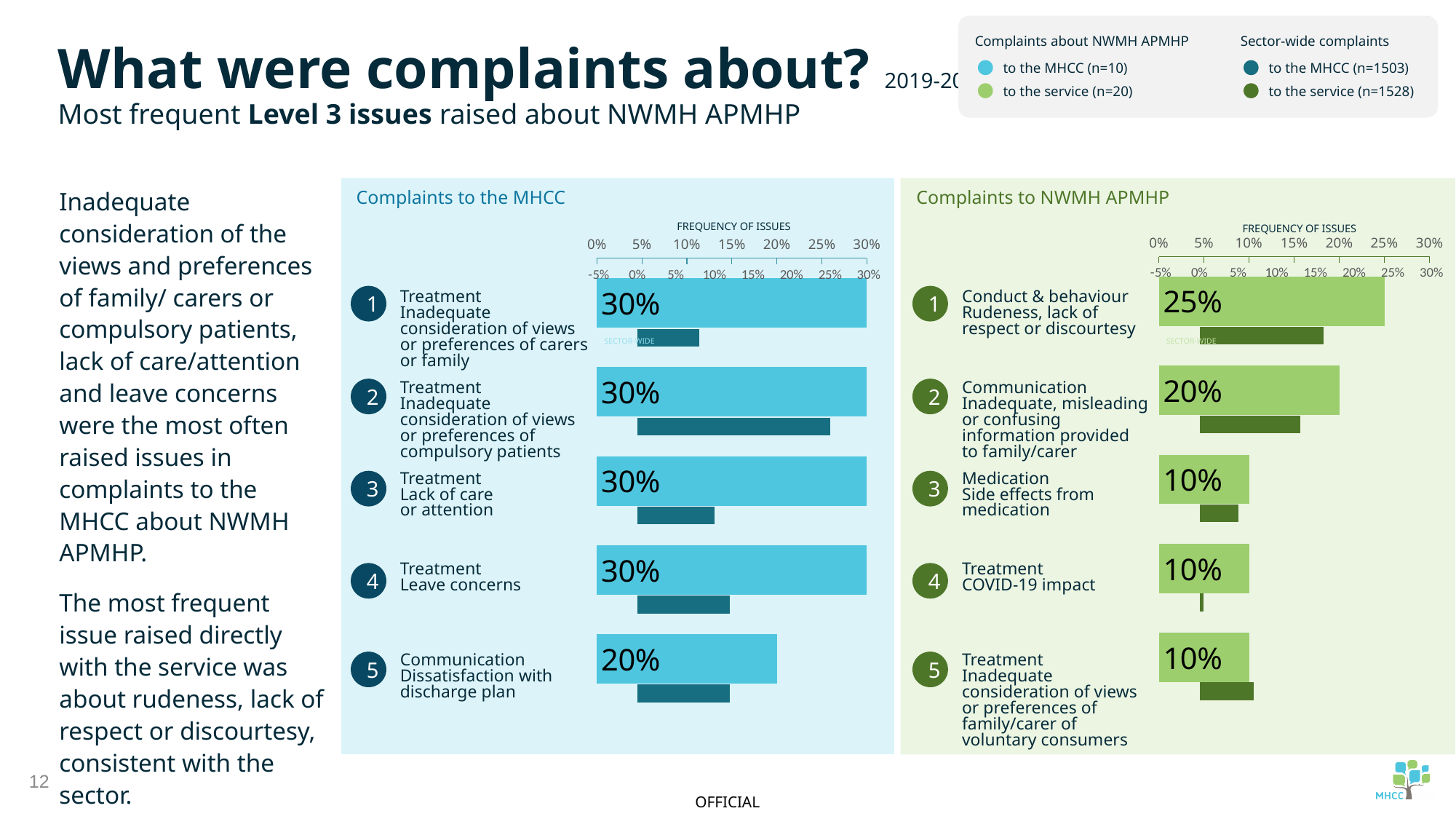
In the 'Complaints to the MHCC' chart, what is the value for 'Communication – Dissatisfaction with discharge plan'? 20% How many issues are listed in the 'Complaints to NWMH APMHP' chart? 5 In the 'Complaints to the MHCC' chart, is the sector-wide bar for 'Treatment – Inadequate consideration of views or preferences of compulsory patients' greater or less than 20%? greater In the 'Complaints to the MHCC' chart, what is the value for 'Treatment – Leave concerns'? 30% In the 'Complaints to NWMH APMHP' chart, what is the value for 'Communication – Inadequate, misleading or confusing information provided to family/carer'? 20% In the 'Complaints to the MHCC' chart, which issue has the lowest frequency? Communication – Dissatisfaction with discharge plan In the 'Complaints to the MHCC' chart, what is the difference between the value for 'Treatment – Lack of care or attention' and the value for 'Communication – Dissatisfaction with discharge plan'? 10% In the 'Complaints to NWMH APMHP' chart, what is the difference between the value for 'Conduct & behaviour' and the value for 'Medication – Side effects from medication'? 15% In the 'Complaints to NWMH APMHP' chart, which issue has the highest frequency? Conduct & behaviour – Rudeness, lack of respect or discourtesy Which is larger: the value for 'Communication' in the 'Complaints to NWMH APMHP' chart or the value for 'Communication' in the 'Complaints to the MHCC' chart? They are equal (20%) What kind of chart is used for 'Complaints to the MHCC'? Bar chart In the 'Complaints to NWMH APMHP' chart, what is the value for 'Conduct & behaviour – Rudeness, lack of respect or discourtesy'? 25%